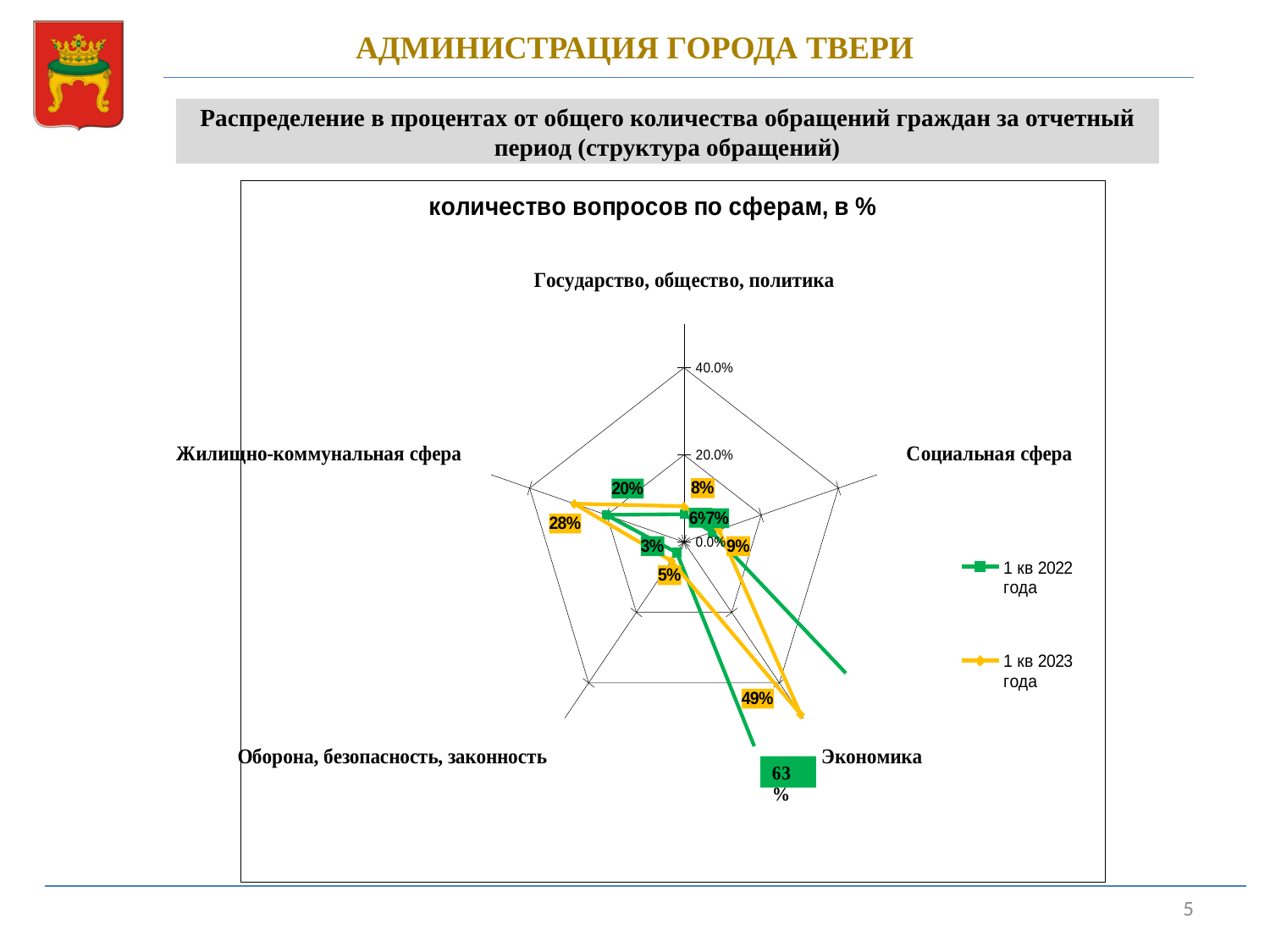
How many categories (spheres) are plotted on the radar chart? 5 Which category has the highest value in the series 1 кв 2023 года? Экономика What kind of chart is shown on the slide? Radar chart How many series does the chart legend list? 2 What is the value for Оборона, безопасность, законность in the series 1 кв 2023 года? 5% What is the value for Жилищно-коммунальная сфера in the series 1 кв 2022 года? 20% What is the value for Экономика in the series 1 кв 2022 года? 63% By how many percentage points does the value for Экономика in 1 кв 2022 года exceed the value in 1 кв 2023 года? 14 What is the title of the chart? количество вопросов по сферам, в % What is the value for Жилищно-коммунальная сфера in the series 1 кв 2023 года? 28% What is the value for Экономика in the series 1 кв 2023 года? 49% Which category has the lowest value in the series 1 кв 2022 года? Оборона, безопасность, законность